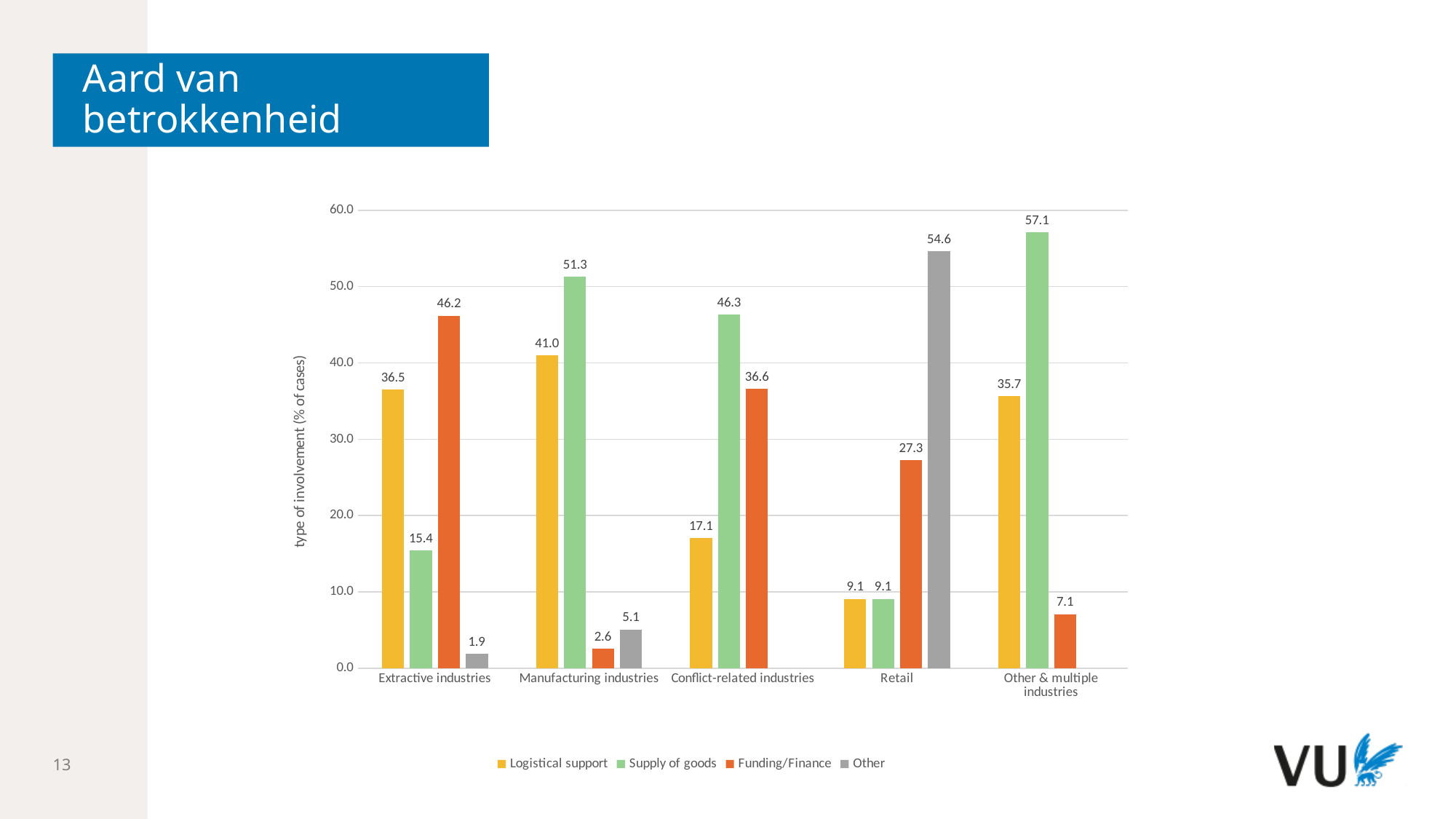
What is the value for Logistical support in Conflict-related industries? 17.1 How many categories are shown on the x axis? 5 What is the difference between Supply of goods and Logistical support in Other & multiple industries? 21.4 What is the value for Funding/Finance in Extractive industries? 46.2 Which is larger in Conflict-related industries: Supply of goods or Funding/Finance? Supply of goods What kind of chart is shown on the slide? Bar chart What is the value for Supply of goods in Manufacturing industries? 51.3 Which category has the highest Supply of goods value? Other & multiple industries Which category has the lowest Funding/Finance value? Manufacturing industries What is the value for Other in Retail? 54.6 How many series does the legend list? 4 What is the label of the vertical axis? type of involvement (% of cases)